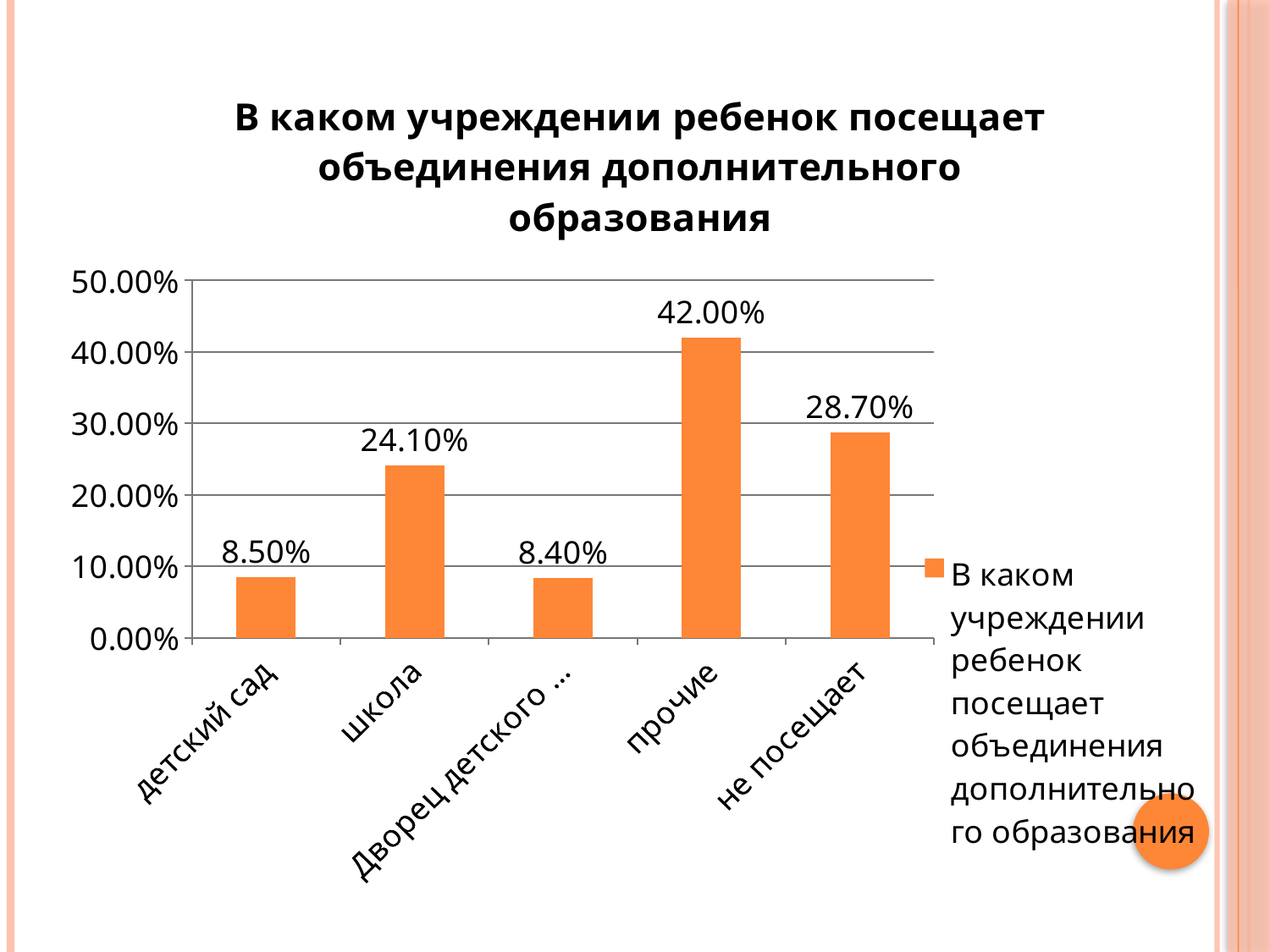
What is the difference between the values for "школа" and "детский сад"? 15.60% What is the value for "школа"? 24.10% What is the value for "детский сад"? 8.50% What is the value for "не посещает"? 28.70% What is the value for "прочие"? 42.00% Which is larger, the value for "школа" or the value for "не посещает"? не посещает How many categories are shown on the x axis? 5 What kind of chart is shown on the slide? bar chart Which category has the highest value? прочие What is the difference between the values for "прочие" and "не посещает"? 13.30% Is the value for "прочие" greater or less than 40.00%? greater How many series does the legend list? 1